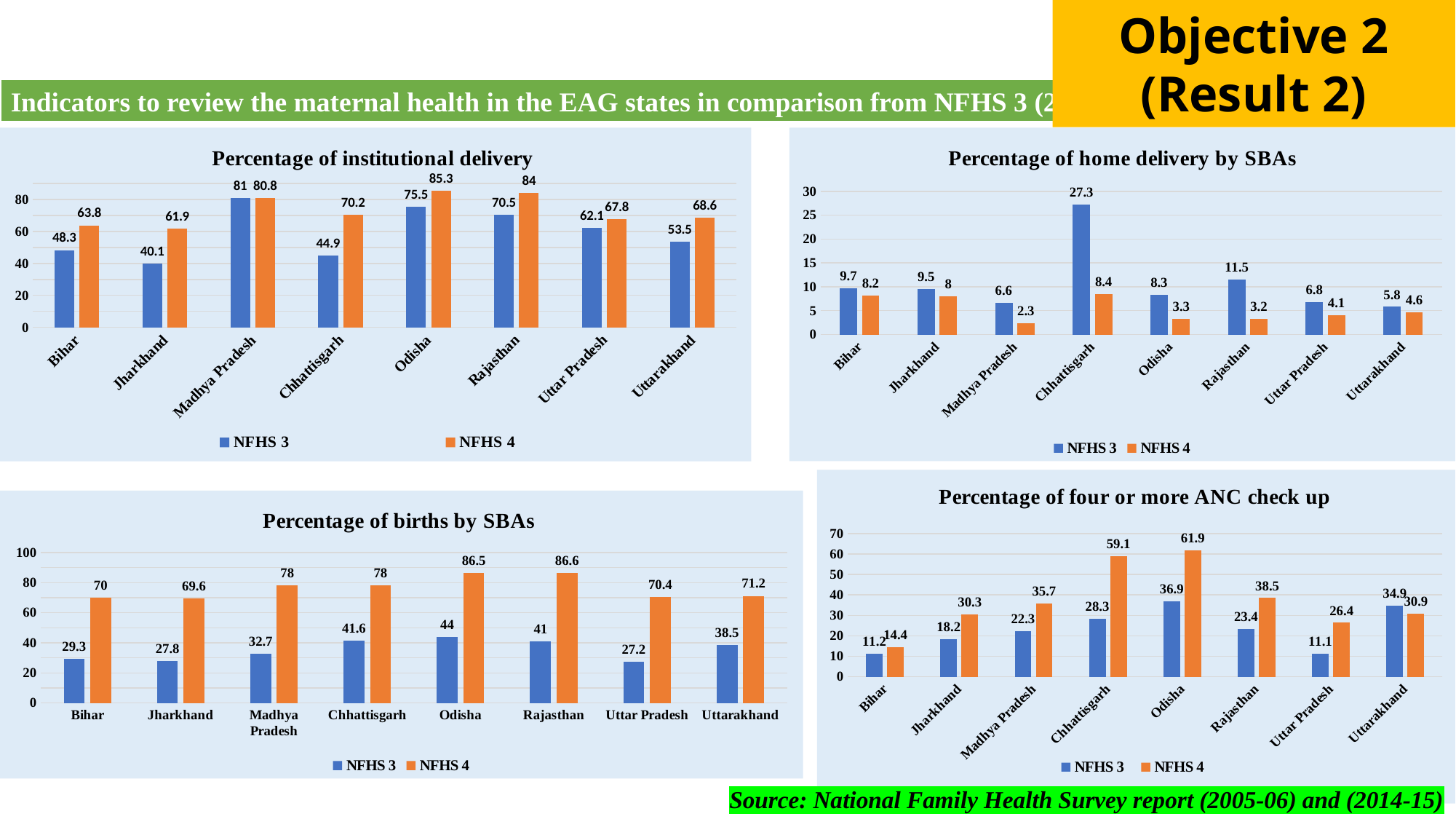
In the 'Percentage of home delivery by SBAs' chart, is the NFHS 3 value for Rajasthan greater or less than 10? greater In the 'Percentage of institutional delivery' chart, what is the NFHS 4 value for Bihar? 63.8 In the 'Percentage of institutional delivery' chart, which state has the highest NFHS 4 value? Odisha In the 'Percentage of births by SBAs' chart, how many states are shown on the x axis? 8 In the 'Percentage of births by SBAs' chart, which is larger for Odisha: the NFHS 3 value or the NFHS 4 value? NFHS 4 In the 'Percentage of institutional delivery' chart, what is the difference between the NFHS 4 and NFHS 3 values for Jharkhand? 21.8 In the 'Percentage of home delivery by SBAs' chart, what is the NFHS 3 value for Chhattisgarh? 27.3 In the 'Percentage of four or more ANC check up' chart, what is the NFHS 3 value for Uttar Pradesh? 11.1 How many series does the legend list in the 'Percentage of four or more ANC check up' chart? 2 In the 'Percentage of four or more ANC check up' chart, which state has the highest NFHS 4 value? Odisha In the 'Percentage of births by SBAs' chart, what is the NFHS 4 value for Rajasthan? 86.6 In the 'Percentage of home delivery by SBAs' chart, which state has the lowest NFHS 4 value? Madhya Pradesh